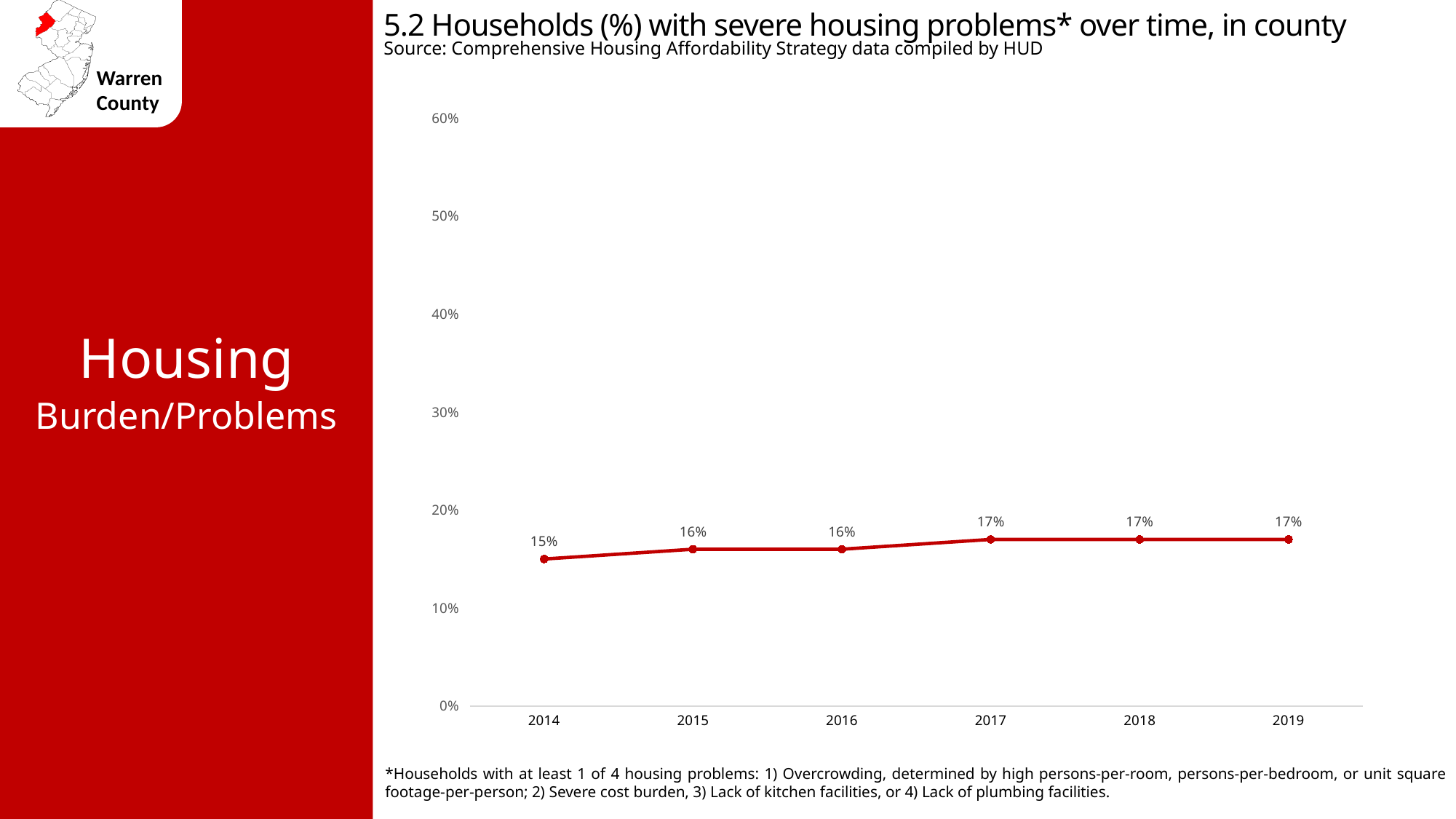
What percentage of households had severe housing problems in 2014? 15% What kind of chart is shown on the slide? Line chart What is the source of the data cited under the chart title? Comprehensive Housing Affordability Strategy data compiled by HUD What is the value shown for 2016? 16% What is the highest value shown on the y axis? 60% How many years are plotted on the chart? 6 What is the difference between the values for 2019 and 2014? 2% Which year has the lowest percentage of households with severe housing problems? 2014 What is the value shown for 2017? 17% Is the value for 2015 larger than the value for 2014? Yes Is the value for 2018 greater or less than 20%? less Do the values generally rise or fall from 2014 to 2019? Rise